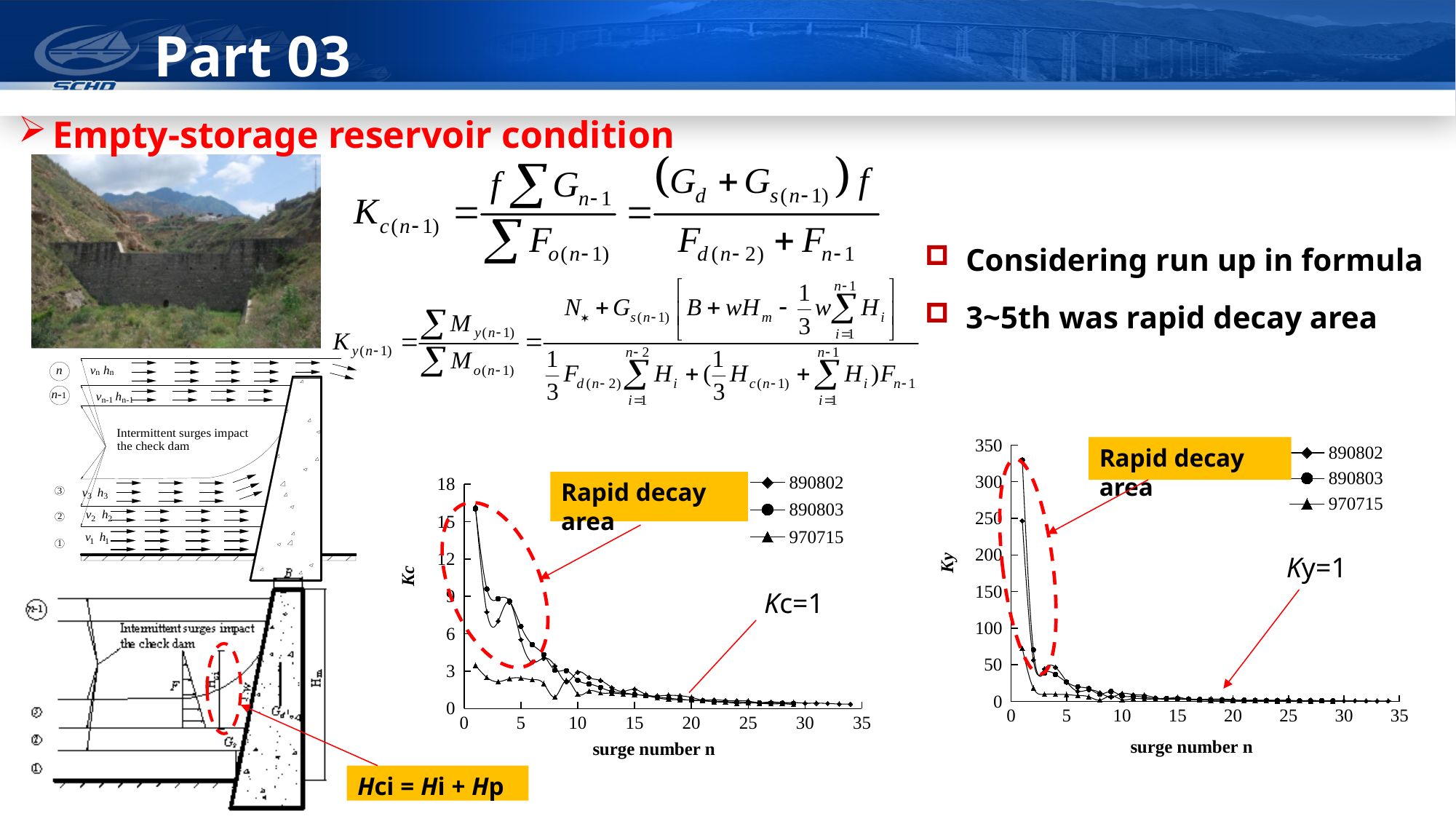
In the right chart (Ky), which series has the lowest value at surge number 1? 970715 In the right chart (Ky), is the value for 890802 at surge number 1 greater or less than 300? less In the left chart (Kc), do the values rise or fall as the surge number n increases? fall In the right chart (Ky), is the value for 970715 at surge number 1 greater or less than 50? greater In the left chart (Kc), is the value for 890803 at surge number 1 greater or less than 12? greater What is the x-axis label of the right chart (Ky)? surge number n What are the legend entries of the left chart (Kc)? 890802, 890803, 970715 What kind of chart is the left chart with y-axis Kc? line chart How many series does the legend of the right chart (Ky) list? 3 In the right chart (Ky), which series has the highest value at surge number 1? 890803 In the right chart (Ky), do the values rise or fall as the surge number n increases? fall